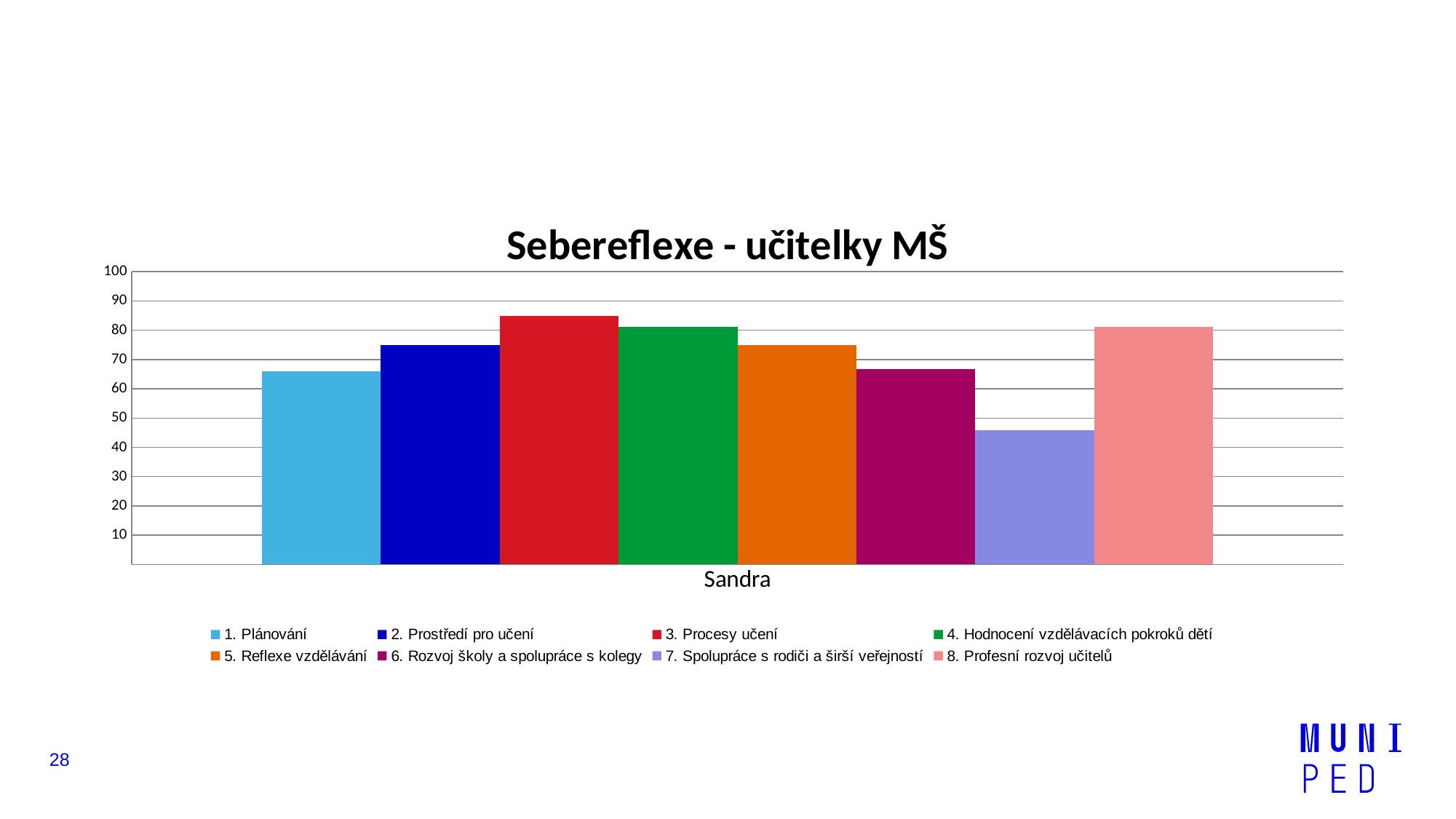
Is the value for 7. Spolupráce s rodiči a širší veřejností greater or less than 50? less Is the value for 3. Procesy učení greater or less than 80? greater How many series does the legend list? 8 Which series has the lowest value? 7. Spolupráce s rodiči a širší veřejností What kind of chart is shown on the slide? bar chart What is the label of the category on the x axis? Sandra What is the title of the chart? Sebereflexe - učitelky MŠ Which is larger, the value for 4. Hodnocení vzdělávacích pokroků dětí or the value for 1. Plánování? 4. Hodnocení vzdělávacích pokroků dětí Which series has the highest value? 3. Procesy učení Which is larger, the value for 7. Spolupráce s rodiči a širší veřejností or the value for 6. Rozvoj školy a spolupráce s kolegy? 6. Rozvoj školy a spolupráce s kolegy Is the value for 1. Plánování greater or less than 60? greater How many categories are shown on the x axis? 1